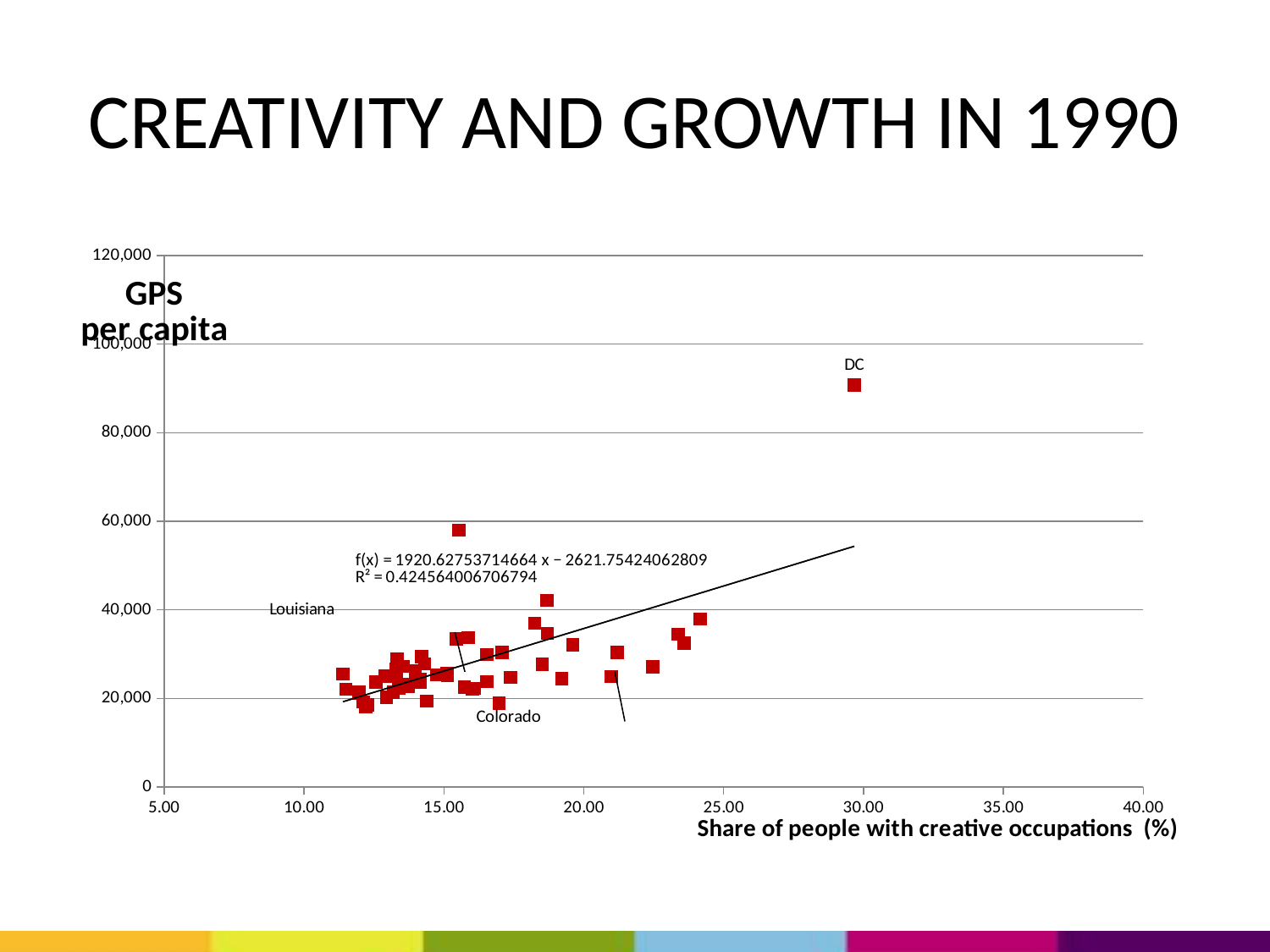
What is the label of the x axis? Share of people with creative occupations (%) What kind of chart is shown on the slide? scatter chart Is the share of people with creative occupations for DC greater or less than 25.00? greater How many data points on the chart are labeled with a name? 3 Which labeled point has the highest GPS per capita? DC What is the slope of the fitted line f(x) printed on the chart? 1920.62753714664 What is the title of the slide's chart? CREATIVITY AND GROWTH IN 1990 Does the fitted trendline rise or fall as the share of people with creative occupations increases? rises What is the R² value printed on the chart? 0.424564006706794 Is the GPS per capita value for DC greater or less than 100,000? less Is the GPS per capita value for DC greater or less than 80,000? greater